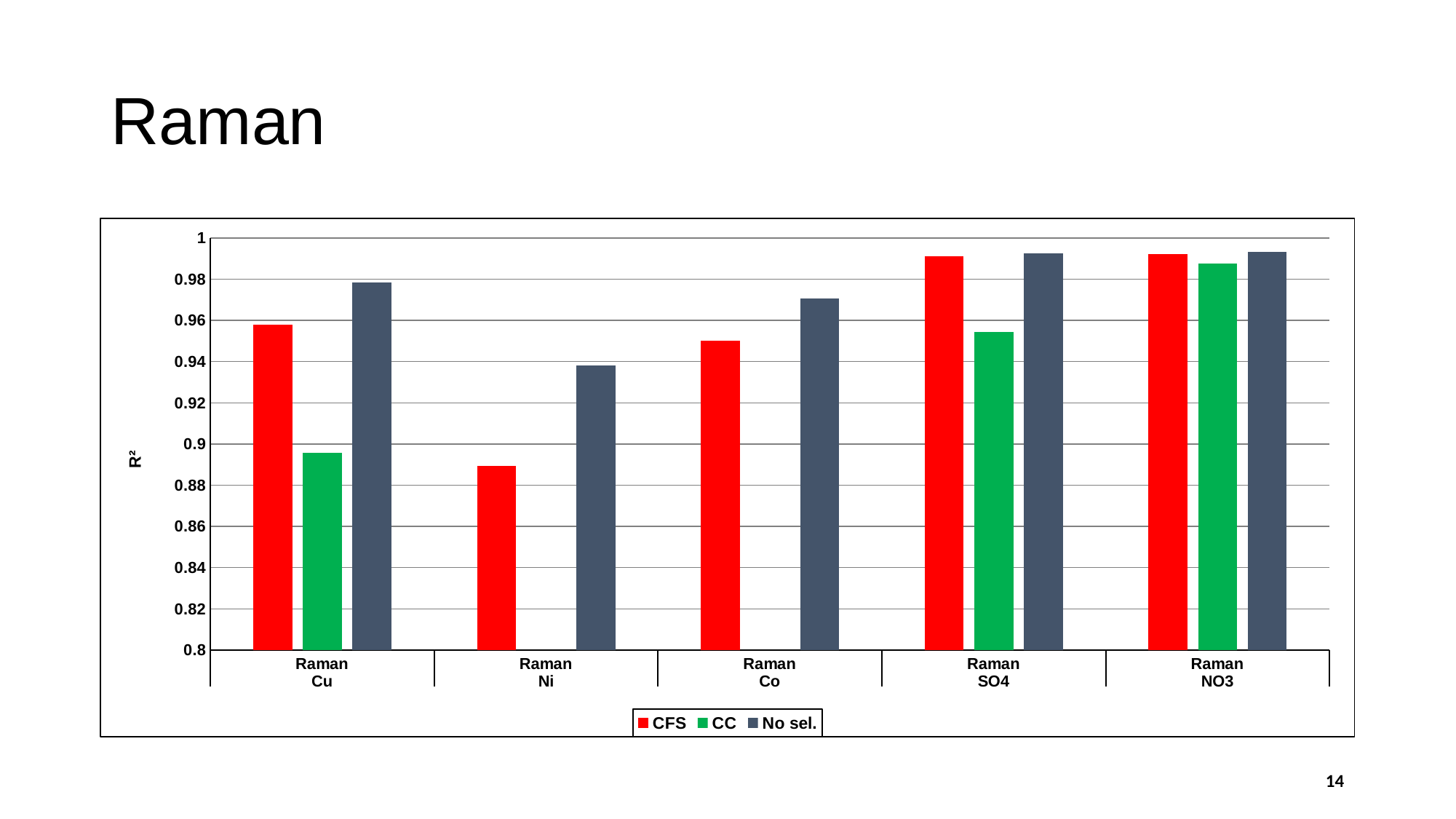
Which categories have no CC bar? Raman Ni and Raman Co Which category has the lowest CFS value? Raman Ni Is the No sel. value for Raman Cu greater or less than 0.96? greater For Raman Cu, which is larger: the CFS value or the CC value? CFS Is the CFS value for Raman Ni greater or less than 0.9? less What kind of chart is shown on the slide? bar chart Which category has the highest CC value? Raman NO3 How many categories are shown on the x axis of the chart? 5 What is the label on the y axis of the chart? R² For Raman Co, which is larger: the No sel. value or the CFS value? No sel. How many series does the legend list? 3 Is the CC value for Raman SO4 greater or less than 0.94? greater